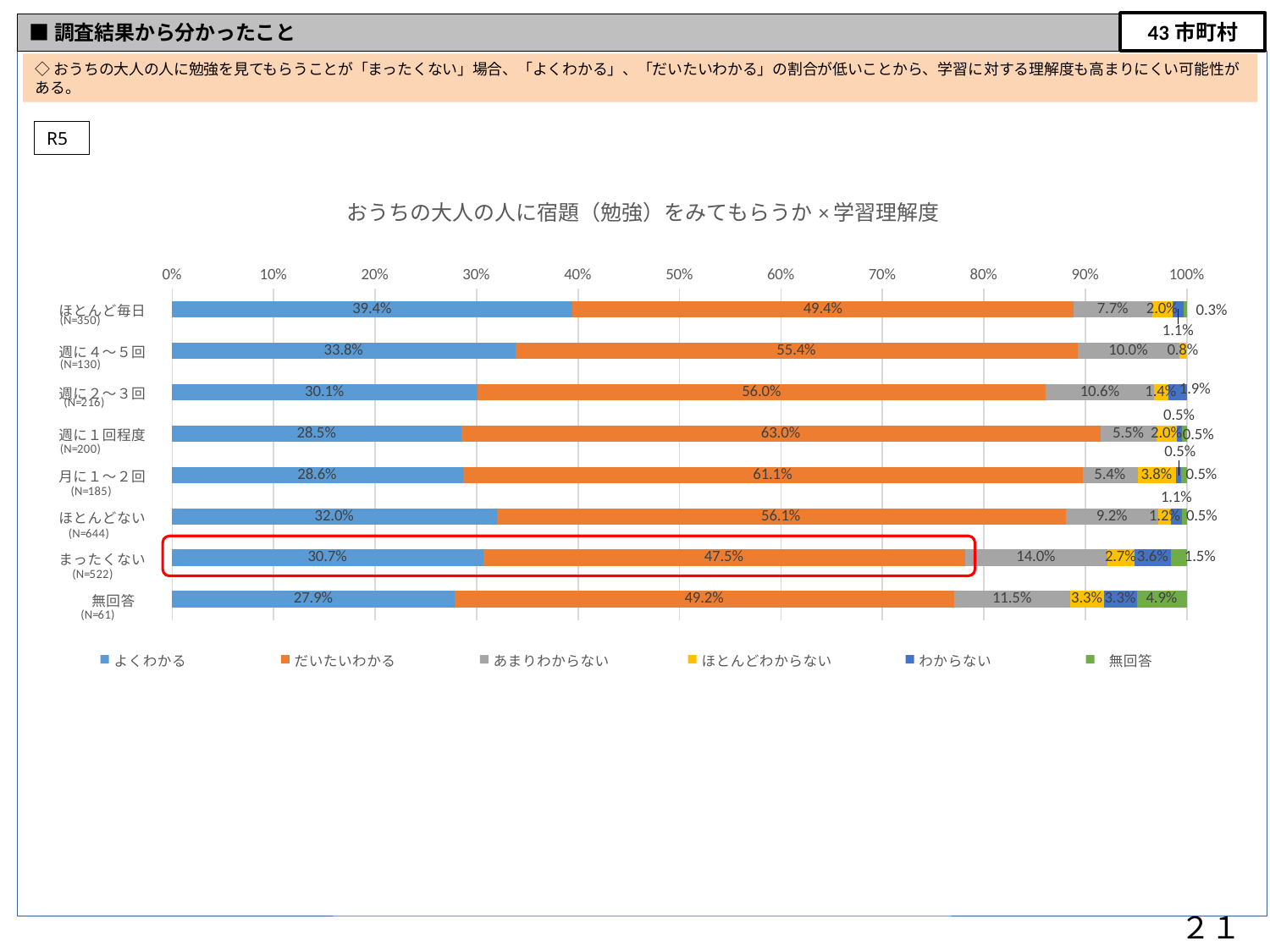
Which is larger, the だいたいわかる value for 週に４～５回 or for ほとんどない? ほとんどない Which category has the lowest だいたいわかる value? まったくない What is the title of the chart? おうちの大人の人に宿題（勉強）をみてもらうか×学習理解度 What is the あまりわからない value for まったくない? 14.0% How many categories are plotted on the vertical axis? 8 What is the 無回答 value for the 無回答 category? 4.9% What is the だいたいわかる value for 週に１回程度? 63.0% How many series does the legend list? 6 What kind of chart is shown on the slide? Stacked bar chart What is the difference between the よくわかる values for ほとんど毎日 and まったくない? 8.7% Which category has the highest よくわかる value? ほとんど毎日 What is the よくわかる value for ほとんど毎日? 39.4%